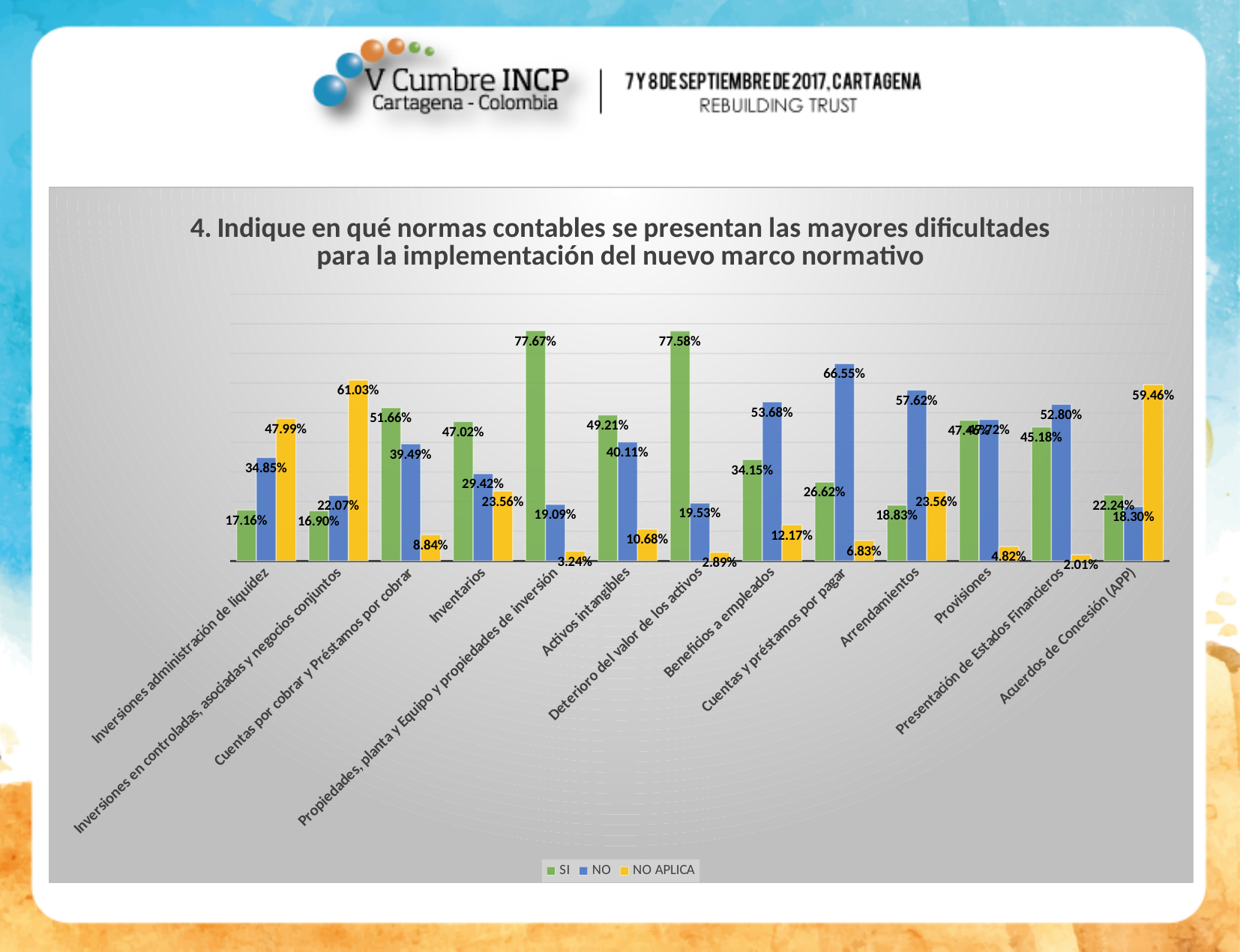
Which series is shown in yellow in the legend? NO APLICA How many categories are shown on the x axis? 13 Which category has the highest NO value? Cuentas y préstamos por pagar What is the NO value for Arrendamientos? 57.62% What is the difference between the NO and SI values for Beneficios a empleados? 19.53% What is the SI value for Deterioro del valor de los activos? 77.58% What is the NO APLICA value for Acuerdos de Concesión (APP)? 59.46% What type of chart is shown on the slide? bar chart What is the SI value for Inventarios? 47.02% How many series does the legend list? 3 What is the difference between the NO APLICA values for Inversiones en controladas, asociadas y negocios conjuntos and Inversiones administración de liquidez? 13.04% Which is larger for Activos intangibles, the SI value or the NO value? SI